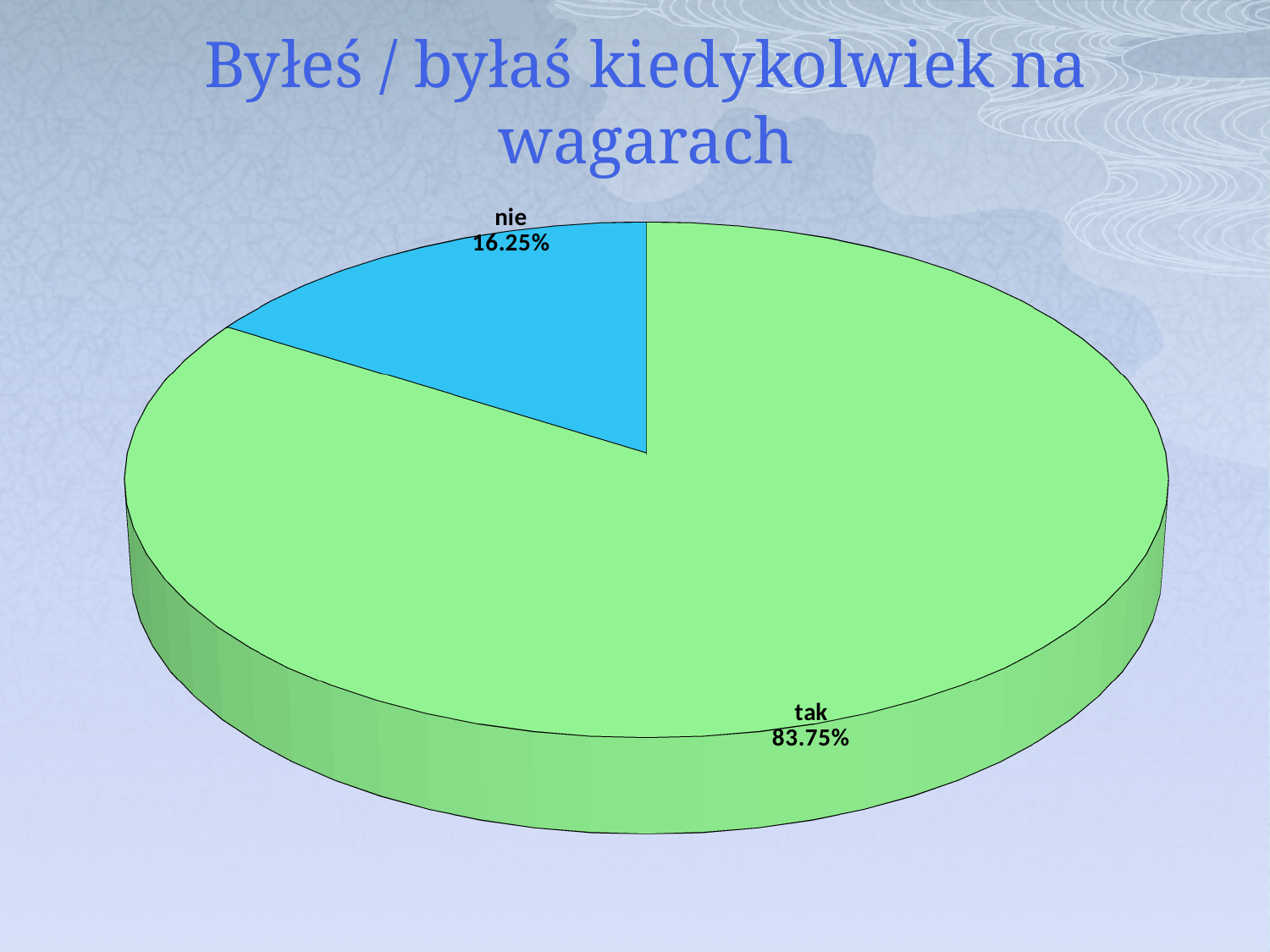
How many slices does the pie chart have? 2 Which is larger, the "tak" slice or the "nie" slice? tak Which slice of the pie is the smallest? nie What percentage of the pie is labelled "nie"? 16.25% What percentage of the pie is labelled "tak"? 83.75% What is the difference in percentage points between the "tak" and "nie" slices? 67.5 Which slice of the pie is the largest? tak What kind of chart is shown on the slide? pie chart What share of the pie does the "nie" slice represent? 16.25% What colour is the "nie" slice of the pie? blue What is the title of the chart on the slide? Byłeś / byłaś kiedykolwiek na wagarach